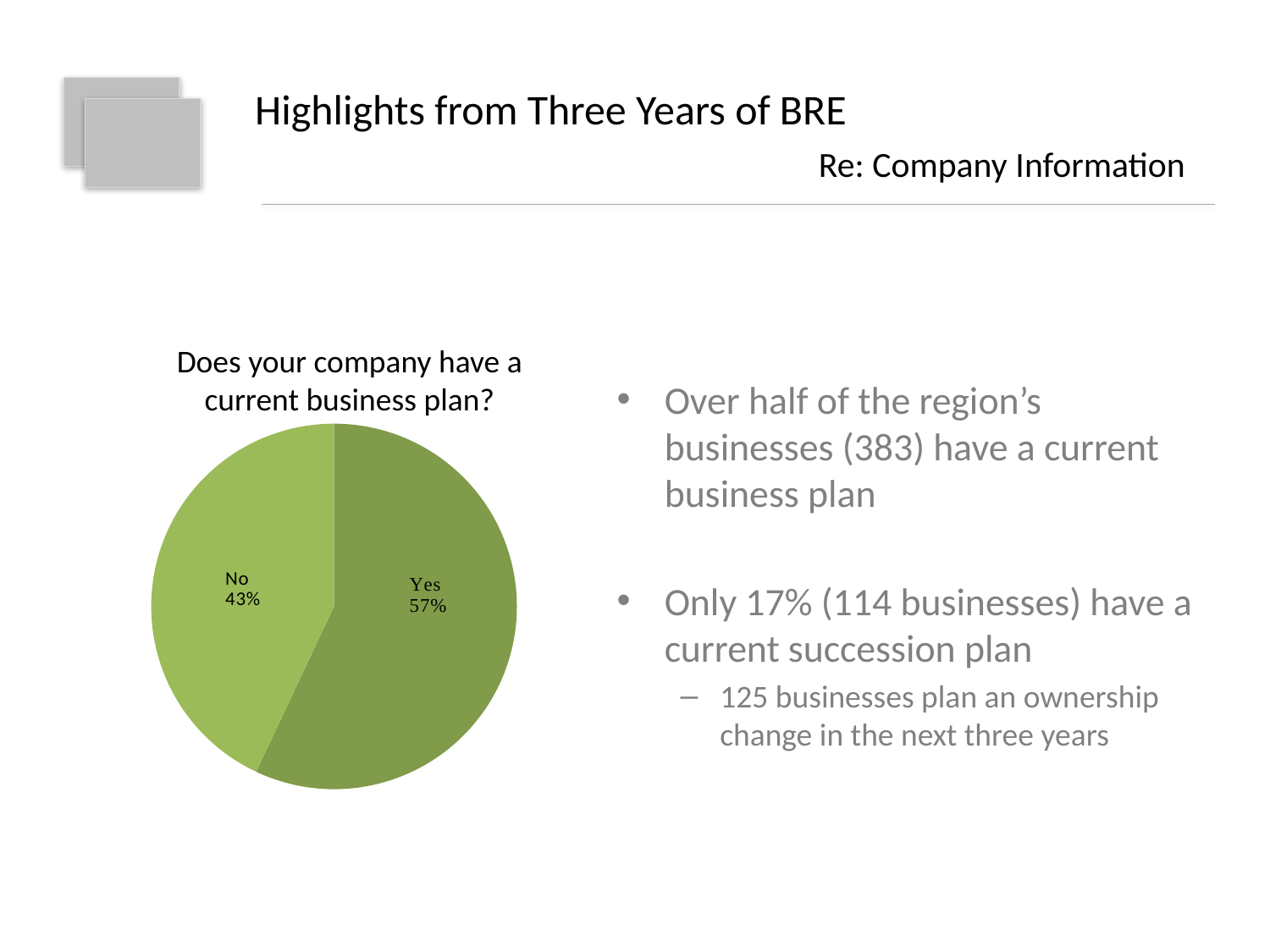
What kind of chart is shown on the slide? Pie chart Is the share for No greater or less than 50%? less What share of the pie is labelled "Yes"? 57% Is the share for Yes greater or less than 50%? greater Which slice of the pie is the largest? Yes What is the total of the two slice percentages shown on the pie? 100% What share of the pie is labelled "No"? 43% Which slice of the pie is the smallest? No What is the title of the chart? Does your company have a current business plan? Which is larger, the Yes slice or the No slice? Yes How many slices does the pie chart have? 2 What is the difference in percentage points between the Yes and No slices? 14